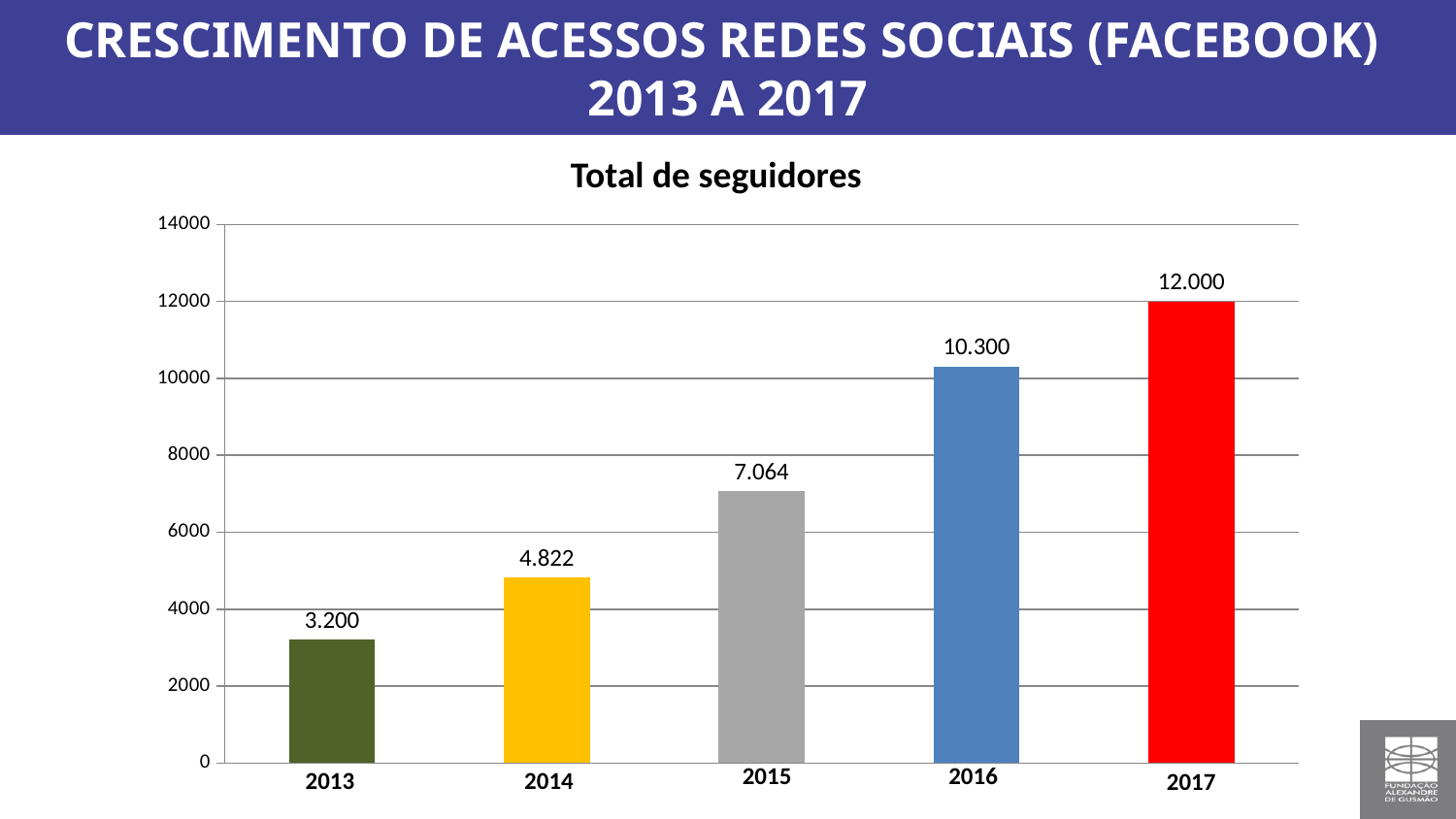
What is the difference between the values for 2017 and 2016? 1.700 What kind of chart is shown on the slide? Bar chart Which year has the lowest total de seguidores? 2013 Which year has the highest total de seguidores? 2017 What is the total de seguidores value for 2017? 12.000 What is the difference between the values for 2014 and 2013? 1.622 Which year has a larger value, 2015 or 2016? 2016 Is the value for 2016 greater or less than 10000? greater How many years are shown on the chart? 5 Do the values rise or fall from 2013 to 2017? Rise What is the total de seguidores value for 2013? 3.200 What is the total de seguidores value for 2015? 7.064